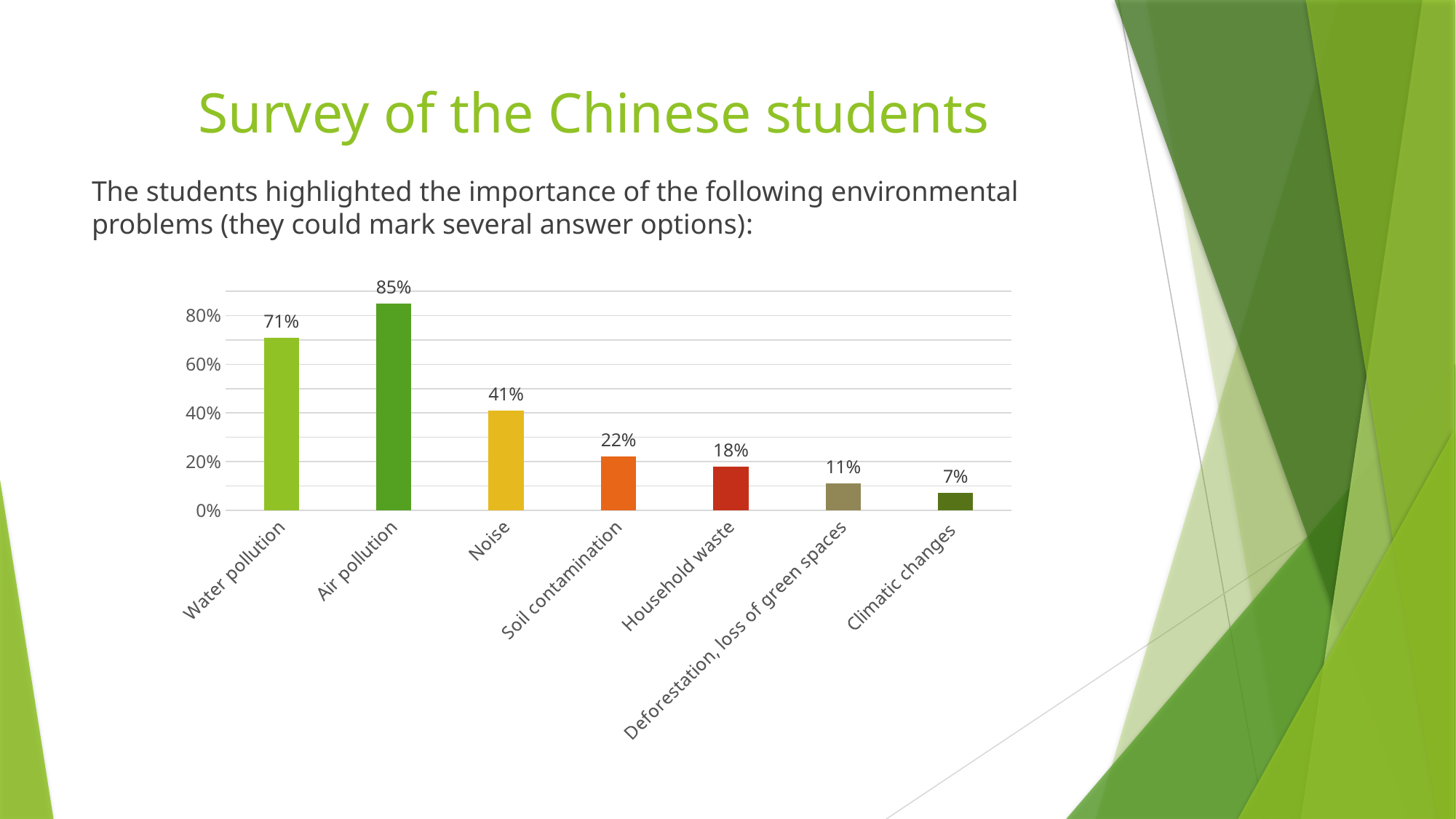
What is the difference between the values for Air pollution and Water pollution? 14% Which environmental problem has the highest value? Air pollution What is the value shown for Noise? 41% What kind of chart is shown on the slide? Bar chart Do the values rise or fall from Air pollution to Climatic changes along the x axis? Fall What percentage is shown for Deforestation, loss of green spaces? 11% What is the difference between the values for Soil contamination and Household waste? 4% Which has a larger value, Noise or Soil contamination? Noise Is the value for Water pollution greater or less than 60%? greater How many environmental problems are shown in the chart? 7 What percentage of students highlighted Air pollution? 85% Which environmental problem has the lowest value? Climatic changes